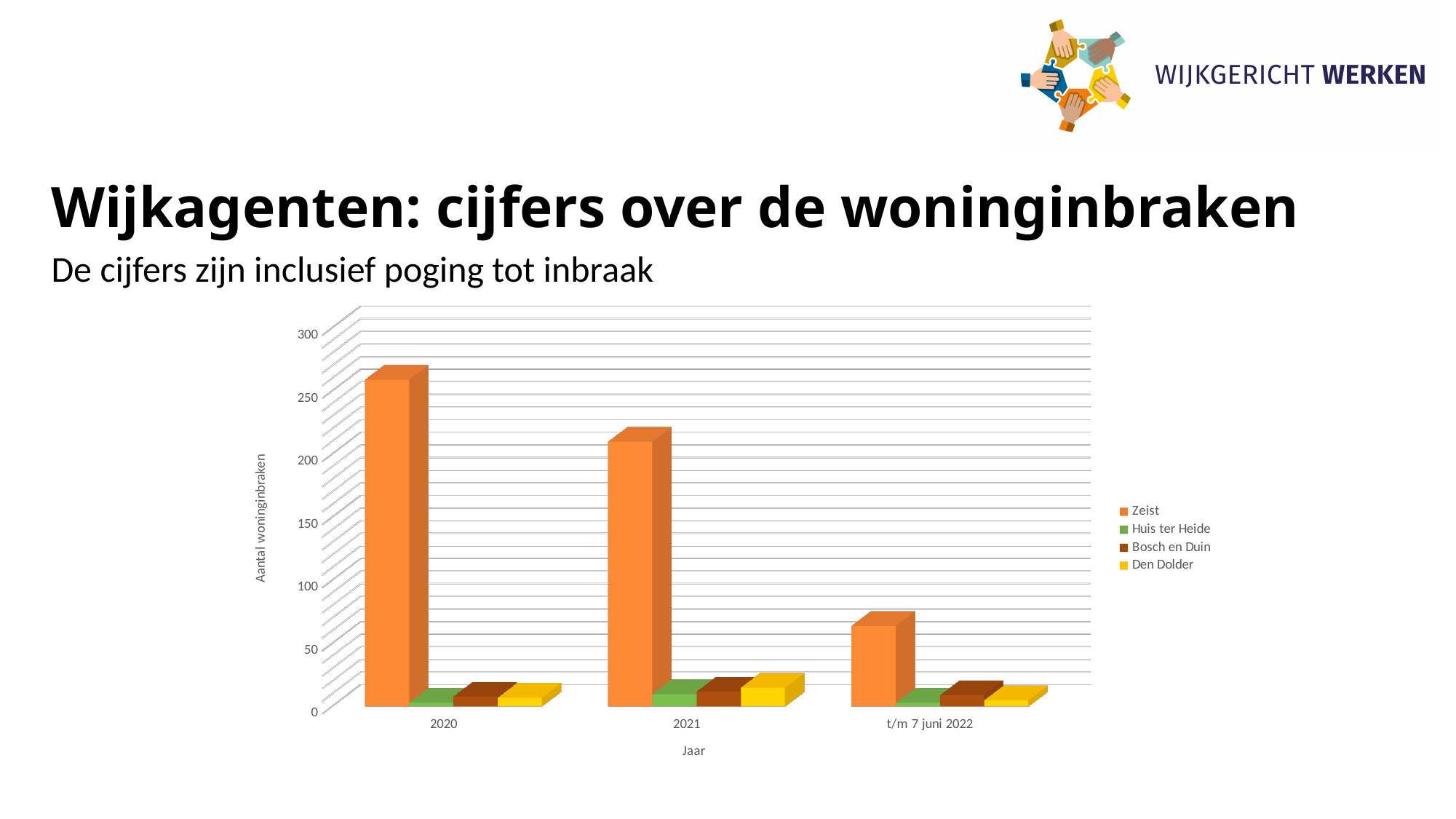
In which category is the value for Zeist lowest? t/m 7 juni 2022 How many series does the legend list? 4 What kind of chart is shown on the slide? bar chart Is the value for Zeist in t/m 7 juni 2022 greater or less than 100? less In which year is the value for Zeist highest? 2020 Is the value for Zeist in 2021 greater or less than 200? greater How many categories are shown on the x axis? 3 Which series is shown in orange in the legend? Zeist Is the value for Zeist in 2020 greater or less than 250? greater Do the values for Zeist rise or fall from 2020 to t/m 7 juni 2022? fall What is the title of the vertical axis? Aantal woninginbraken Which is larger in 2021: the value for Zeist or the value for Den Dolder? Zeist